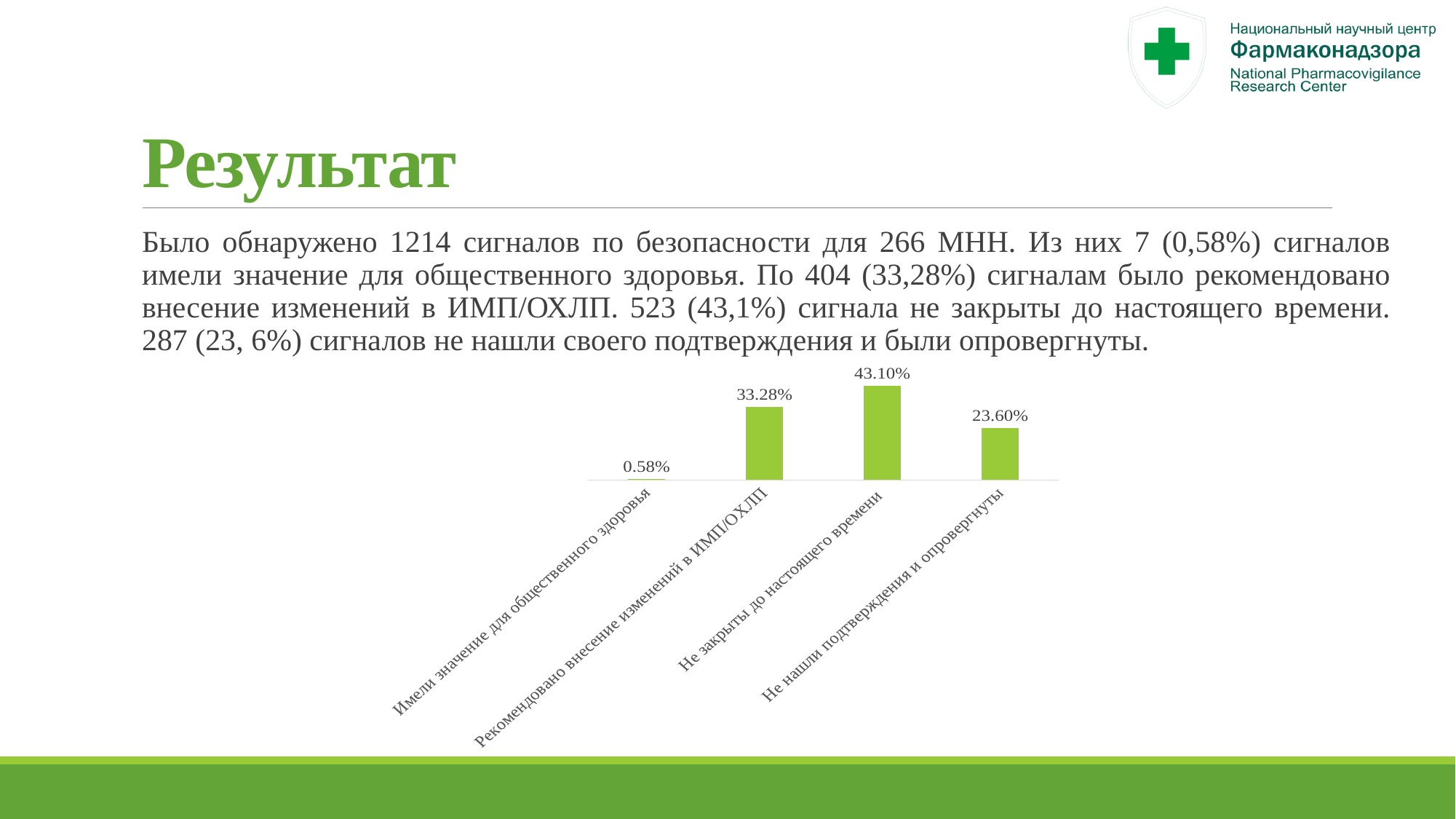
What is the difference between the values for "Не закрыты до настоящего времени" and "Не нашли подтверждения и опровергнуты"? 19.50% What value is shown for the category "Не закрыты до настоящего времени"? 43.10% What is the difference between the values for "Не закрыты до настоящего времени" and "Рекомендовано внесение изменений в ИМП/ОХЛП"? 9.82% What kind of chart is shown on the slide? Bar chart Which is larger: the value for "Рекомендовано внесение изменений в ИМП/ОХЛП" or the value for "Не нашли подтверждения и опровергнуты"? Рекомендовано внесение изменений в ИМП/ОХЛП Which category has the highest value in the chart? Не закрыты до настоящего времени What colour are the bars in the chart? Green How many categories are shown in the chart? 4 What value is shown for the category "Не нашли подтверждения и опровергнуты"? 23.60% What value is shown for the category "Имели значение для общественного здоровья"? 0.58% Which category has the lowest value in the chart? Имели значение для общественного здоровья What value is shown for the category "Рекомендовано внесение изменений в ИМП/ОХЛП"? 33.28%